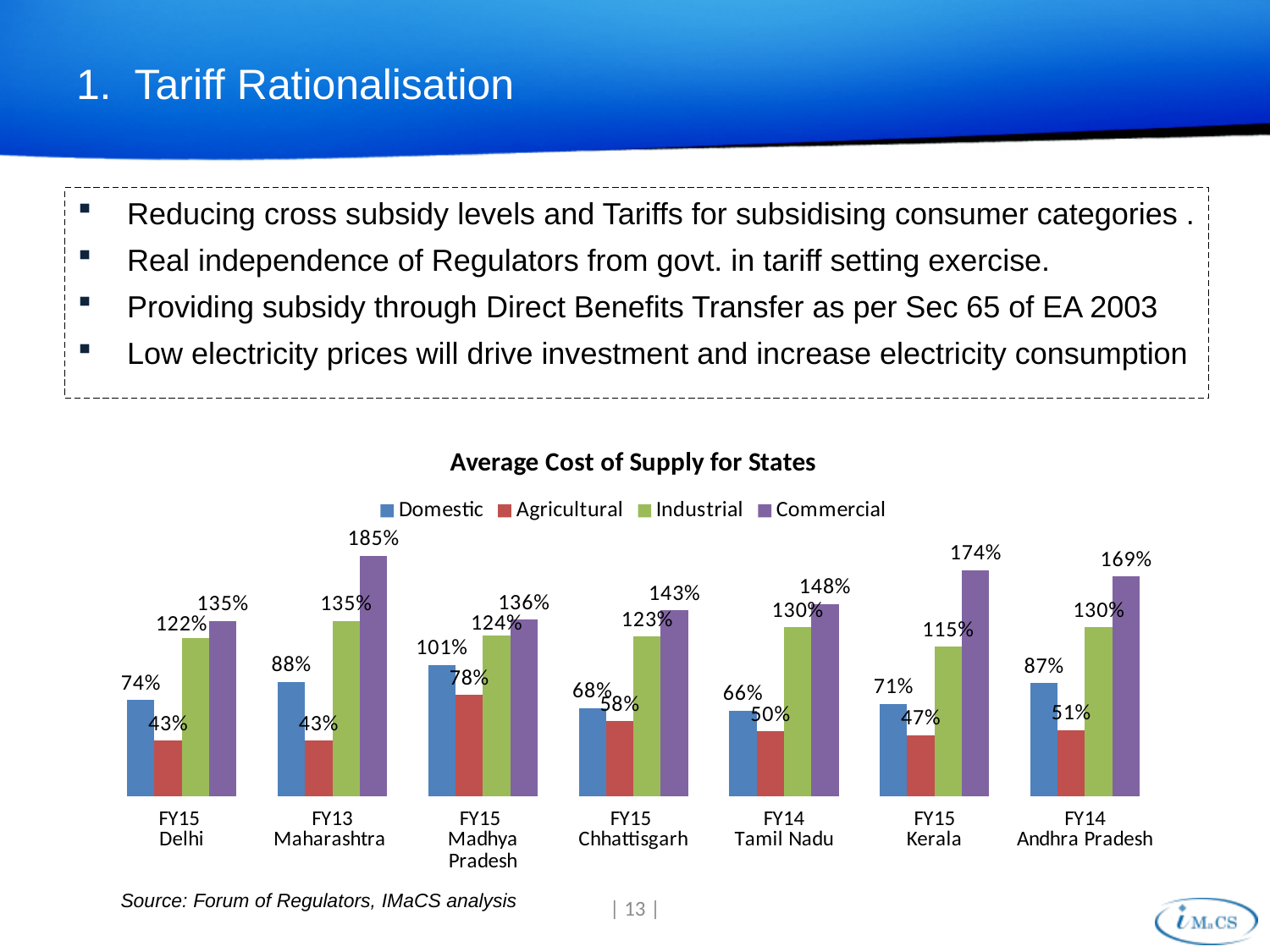
Which state has the highest Commercial value? FY13 Maharashtra What kind of chart is shown on the slide? Bar chart What is the difference between the Commercial and Domestic values for FY15 Kerala? 103% What is the Domestic value for FY15 Madhya Pradesh? 101% How many states are shown on the x axis? 7 What is the title of the chart? Average Cost of Supply for States Which is larger, the Industrial value for FY15 Delhi or the Industrial value for FY15 Chhattisgarh? FY15 Chhattisgarh How many series does the legend list? 4 What is the Commercial value for FY13 Maharashtra? 185% Which state has the lowest Domestic value? FY14 Tamil Nadu What is the Agricultural value for FY15 Kerala? 47% What is the Industrial value for FY14 Tamil Nadu? 130%